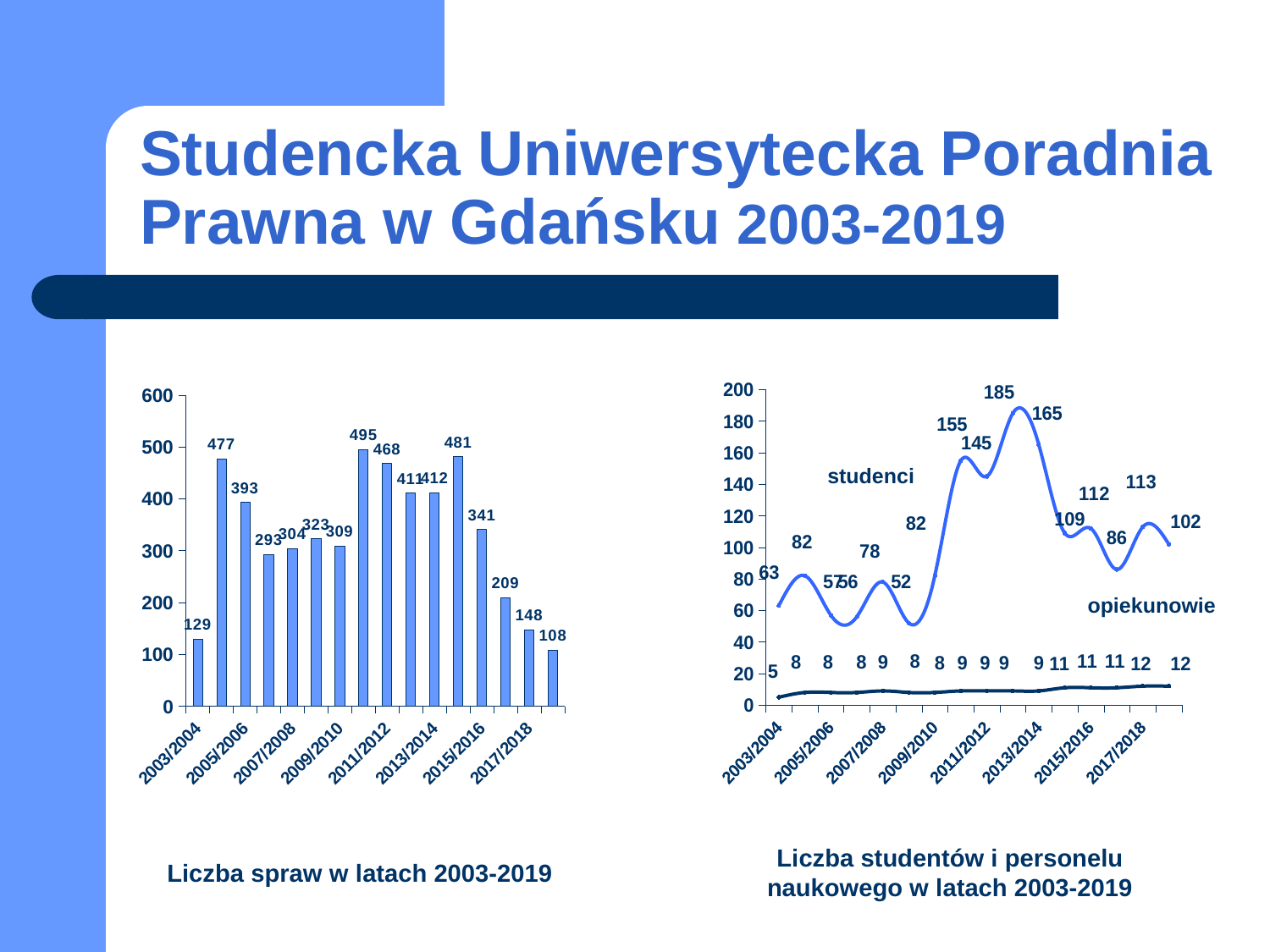
In the left chart 'Liczba spraw w latach 2003-2019', what is the lowest value shown? 108 In the left chart 'Liczba spraw w latach 2003-2019', what is the highest value shown? 495 What kind of chart is the right chart, 'Liczba studentów i personelu naukowego w latach 2003-2019'? line chart In the left chart 'Liczba spraw w latach 2003-2019', what is the value for 2003/2004? 129 In the left chart 'Liczba spraw w latach 2003-2019', what is the value for 2005/2006? 393 What kind of chart is the left chart, 'Liczba spraw w latach 2003-2019'? bar chart In the right chart, does the 'opiekunowie' series generally rise or fall from 2003/2004 to the last year? rise In the left chart 'Liczba spraw w latach 2003-2019', what is the difference between the highest value (495) and the second highest value (481)? 14 In the left chart 'Liczba spraw w latach 2003-2019', how many bars are plotted? 16 In the right chart, what is the lowest value of the 'opiekunowie' series? 5 In the right chart, what is the highest value of the 'studenci' series? 185 How many data series are plotted in the right chart 'Liczba studentów i personelu naukowego w latach 2003-2019'? 2